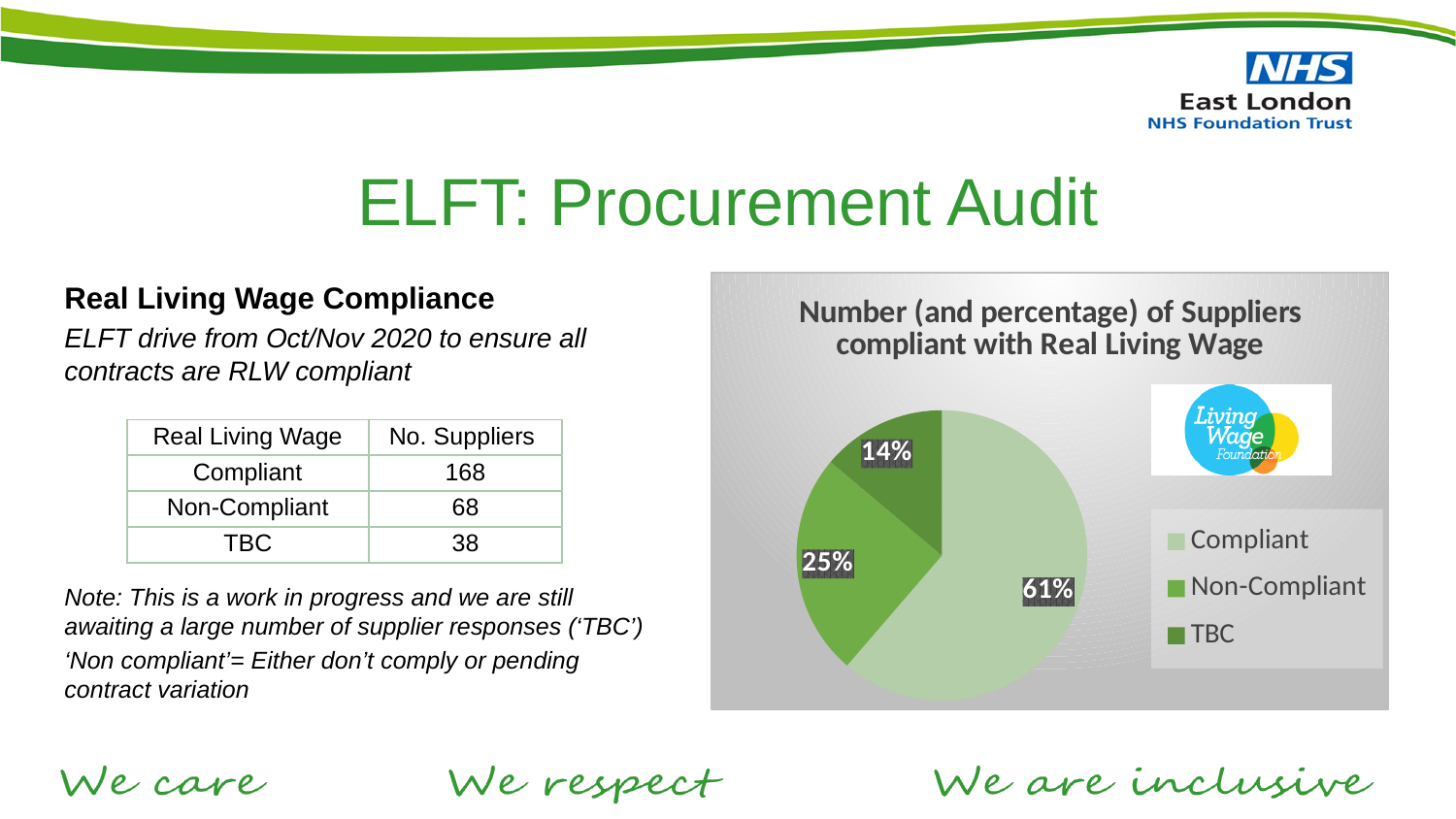
In the pie chart, which slice is larger: Non-Compliant or TBC? Non-Compliant Which category has the largest slice in the pie chart? Compliant What is the difference in percentage points between the Compliant and Non-Compliant slices in the pie chart? 36 What kind of chart is shown on the slide? Pie chart Which category has the smallest slice in the pie chart? TBC What percentage of suppliers does the Compliant slice represent in the pie chart? 61% How many slices does the pie chart have? 3 What percentage of suppliers does the TBC slice represent in the pie chart? 14% How many entries does the pie chart's legend list? 3 What is the title of the pie chart? Number (and percentage) of Suppliers compliant with Real Living Wage Which legend entry in the pie chart is shown in the lightest green? Compliant What percentage of suppliers does the Non-Compliant slice represent in the pie chart? 25%